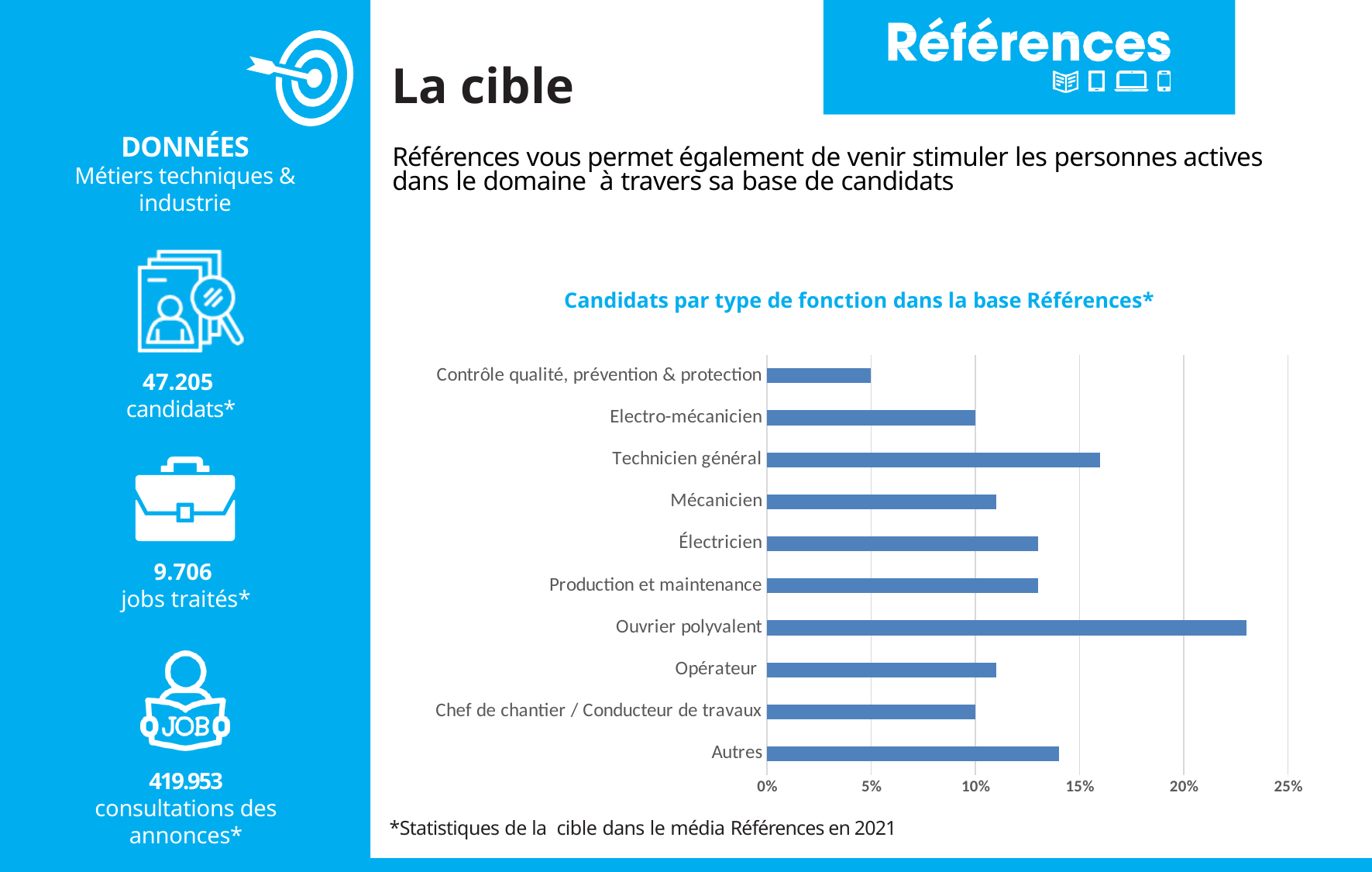
What is the highest value shown on the horizontal axis of the chart? 25% How many function categories are plotted in the chart? 10 What kind of chart is shown on the slide? bar chart Which is larger, the value for Autres or the value for Opérateur? Autres Which is larger, the value for Technicien général or the value for Électricien? Technicien général Which category has the highest share of candidates? Ouvrier polyvalent Is the value for Mécanicien greater or less than 15%? less Which category has the lowest share of candidates? Contrôle qualité, prévention & protection Is the value for Technicien général greater or less than 15%? greater Is the value for Autres greater or less than 10%? greater What is the title of the chart? Candidats par type de fonction dans la base Références*